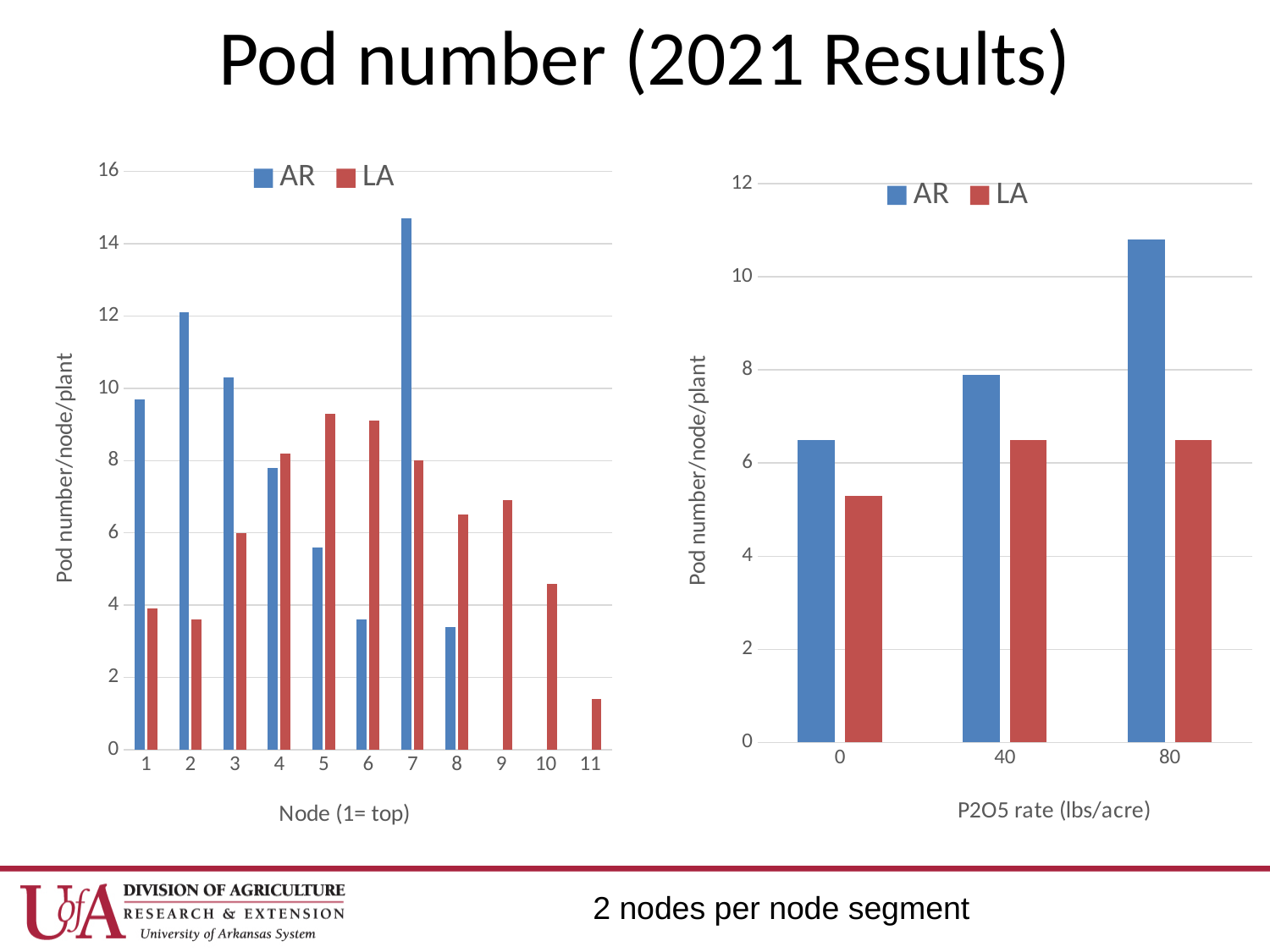
In the right chart (P2O5 rate), do the AR values rise or fall as the P2O5 rate increases? rise In the right chart (P2O5 rate), is the AR value at 80 lbs/acre greater or less than 10? greater In the left chart (Node), what kind of chart is shown? bar chart In the left chart (Node), at which node is the AR value highest? 7 In the left chart (Node), is the AR value at node 7 greater or less than 14? greater In the right chart (P2O5 rate), how many P2O5 rate categories are shown? 3 In the left chart (Node), is the LA value at node 11 greater or less than 2? less In the left chart (Node), how many node categories are shown on the x axis? 11 In the left chart (Node), at node 5, which series has the larger value, AR or LA? LA In the left chart (Node), at which node is the LA value highest? 5 In the left chart (Node), at which node is the LA value lowest? 11 In the left chart (Node), how many series does the legend list? 2